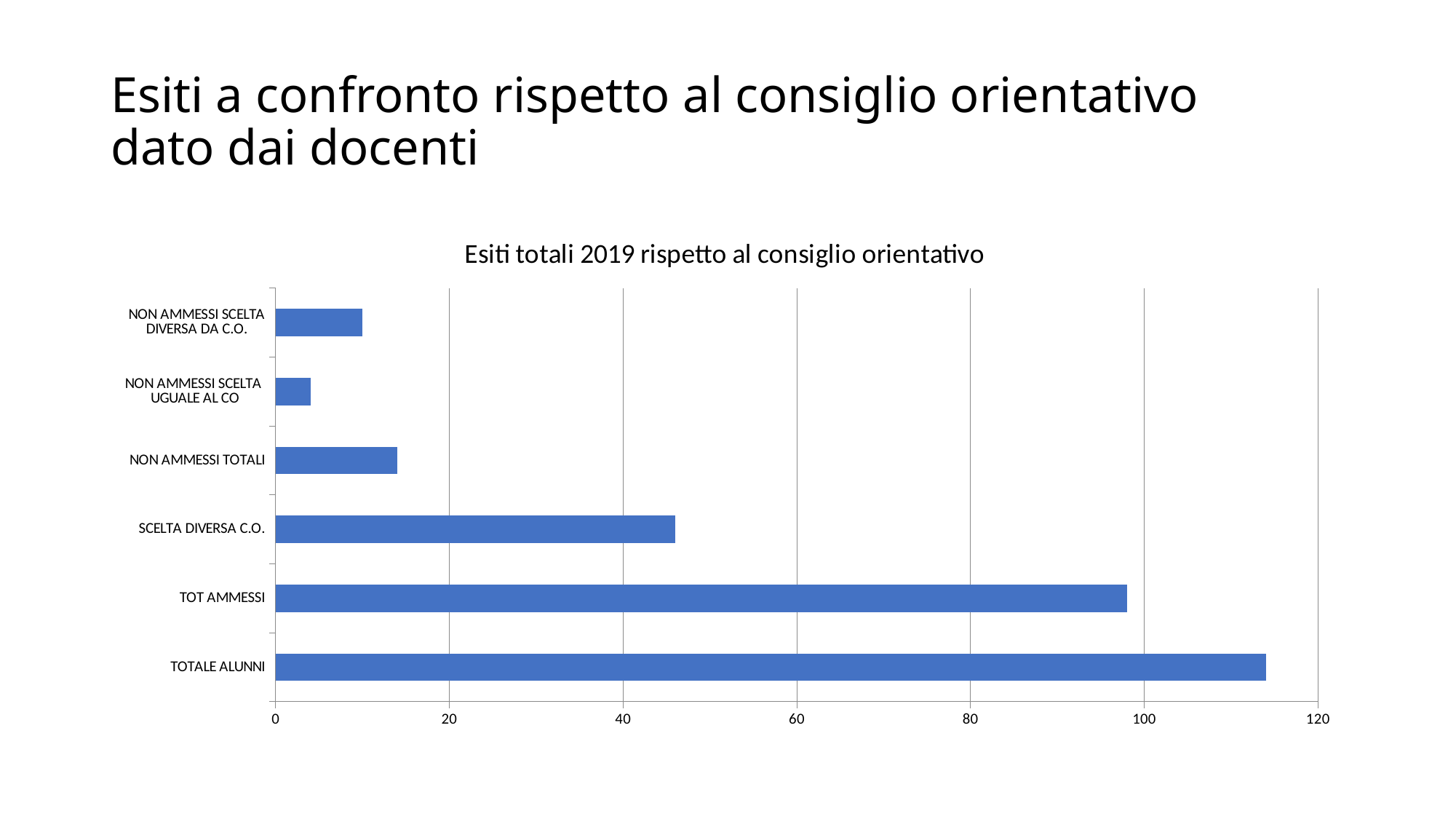
How many categories are plotted in the chart? 6 Which is larger, the value for SCELTA DIVERSA C.O. or the value for TOT AMMESSI? TOT AMMESSI Is the value for TOTALE ALUNNI greater or less than 100? greater Which category has the lowest value? NON AMMESSI SCELTA UGUALE AL CO What is the maximum value shown on the horizontal axis? 120 Is the value for NON AMMESSI TOTALI greater or less than 20? less What is the title of the chart? Esiti totali 2019 rispetto al consiglio orientativo Is the value for SCELTA DIVERSA C.O. greater or less than 40? greater What kind of chart is shown on the slide? bar chart Which category has the highest value? TOTALE ALUNNI Which is larger, the value for NON AMMESSI SCELTA DIVERSA DA C.O. or the value for NON AMMESSI SCELTA UGUALE AL CO? NON AMMESSI SCELTA DIVERSA DA C.O.